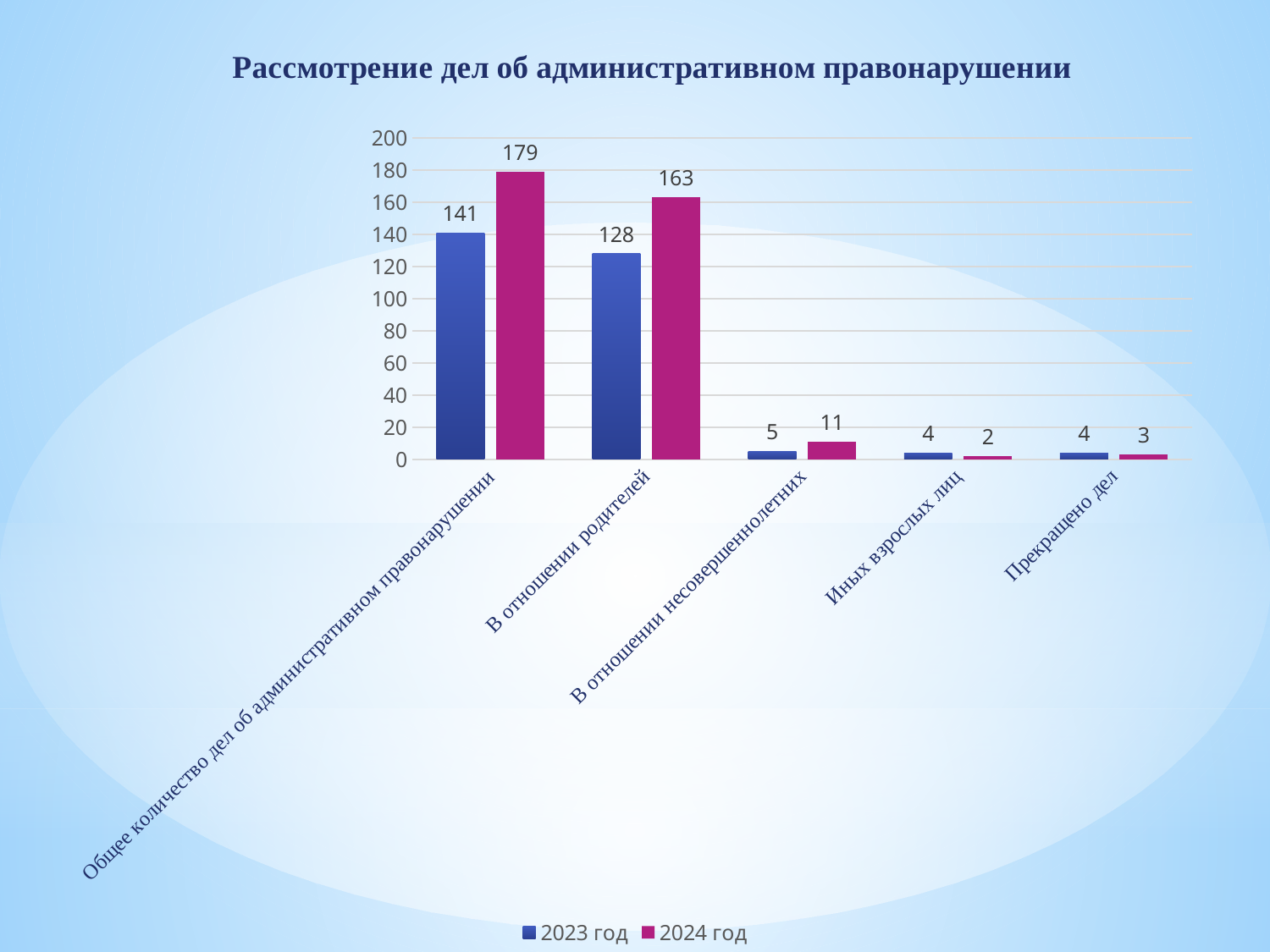
What is the value for 2024 год in the category 'Общее количество дел об административном правонарушении'? 179 How many series does the legend list? 2 What kind of chart is shown on the slide? bar chart What is the difference between the 2024 год and 2023 год values for 'В отношении родителей'? 35 What is the value for 2023 год in the category 'В отношении родителей'? 128 Which is larger for 'Прекращено дел': the 2023 год value or the 2024 год value? 2023 год Which category has the lowest value for the 2024 год series? Иных взрослых лиц How many categories are shown on the x axis? 5 Is the 2023 год value for 'Общее количество дел об административном правонарушении' greater or less than 160? less What is the title of the chart? Рассмотрение дел об административном правонарушении What is the value for 2024 год in the category 'В отношении несовершеннолетних'? 11 Which category has the highest value for the 2023 год series? Общее количество дел об административном правонарушении